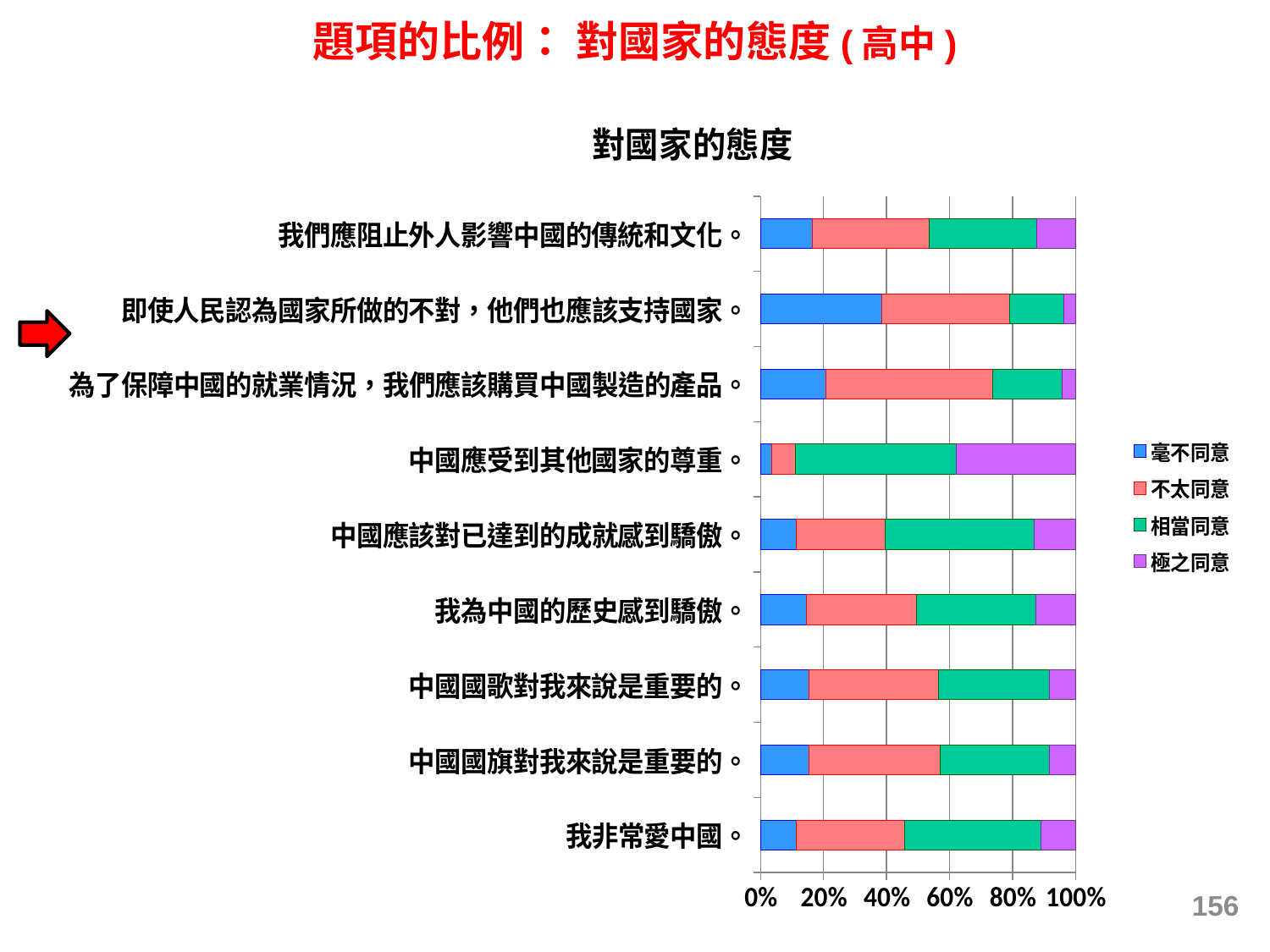
Is the 毫不同意 share for 即使人民認為國家所做的不對，他們也應該支持國家。 greater or less than 20%? greater Which statement has the largest 毫不同意 share? 即使人民認為國家所做的不對，他們也應該支持國家。 How many series does the legend list? 4 How many statements (categories) are plotted in the chart? 9 Which statement has the largest 極之同意 share? 中國應受到其他國家的尊重。 What kind of chart is shown on the slide? Stacked bar chart Which legend entry is shown in purple? 極之同意 Is the 毫不同意 share for 中國應受到其他國家的尊重。 greater or less than 20%? less Is the 極之同意 share for 中國應受到其他國家的尊重。 greater or less than 20%? greater Which statement has the smallest 毫不同意 share? 中國應受到其他國家的尊重。 Which is larger: the 相當同意 share for 中國應受到其他國家的尊重。 or for 即使人民認為國家所做的不對，他們也應該支持國家。? 中國應受到其他國家的尊重。 What is the title of the chart? 對國家的態度